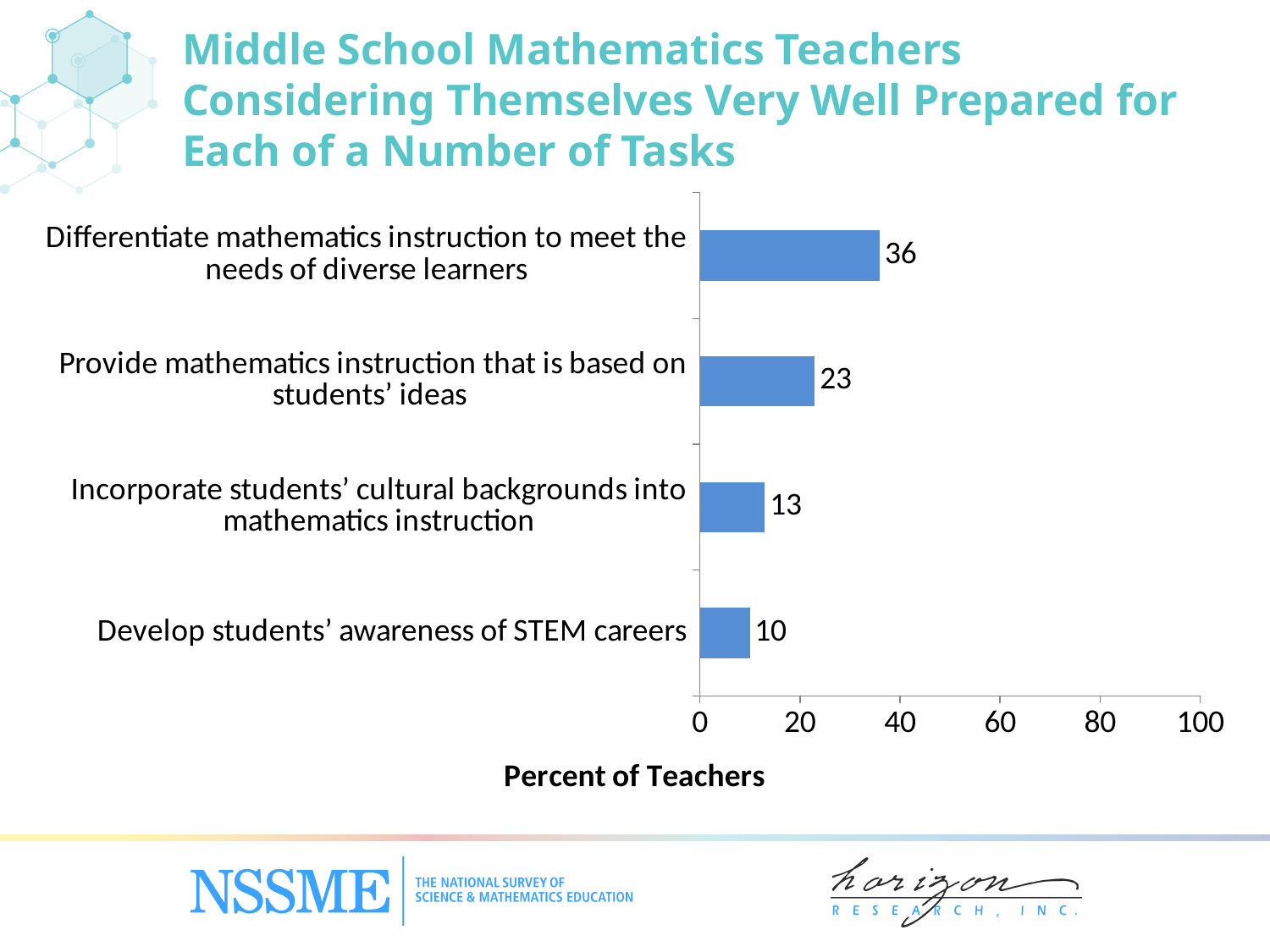
What percent of teachers consider themselves very well prepared to provide mathematics instruction that is based on students' ideas? 23 What percent of teachers consider themselves very well prepared to incorporate students' cultural backgrounds into mathematics instruction? 13 Which has a larger percent: providing mathematics instruction based on students' ideas or incorporating students' cultural backgrounds into mathematics instruction? Provide mathematics instruction that is based on students' ideas What is the difference in percent between differentiating mathematics instruction for diverse learners and developing students' awareness of STEM careers? 26 How many tasks are shown in the chart? 4 What type of chart is shown on the slide? Bar chart What percent of teachers consider themselves very well prepared to differentiate mathematics instruction to meet the needs of diverse learners? 36 Which task has the lowest percent of teachers considering themselves very well prepared? Develop students' awareness of STEM careers Which task has the highest percent of teachers considering themselves very well prepared? Differentiate mathematics instruction to meet the needs of diverse learners What percent of teachers consider themselves very well prepared to develop students' awareness of STEM careers? 10 Is the value for differentiating mathematics instruction to meet the needs of diverse learners greater or less than 40? less What is the difference in percent between providing instruction based on students' ideas and incorporating students' cultural backgrounds? 10